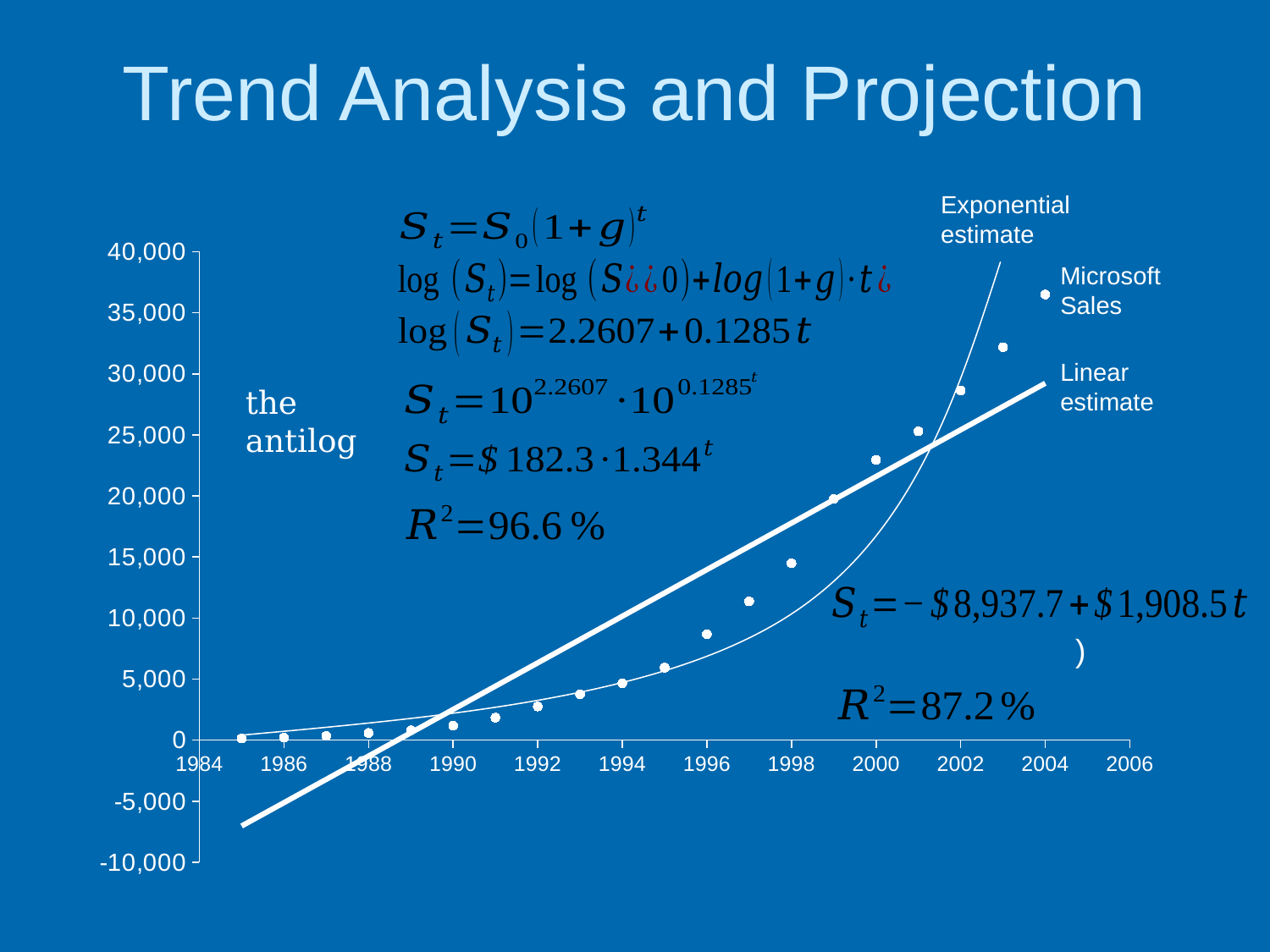
Is the Microsoft Sales value for 2002 greater or less than 30,000? less Which year has the highest Microsoft Sales value plotted? 2004 Is the Microsoft Sales value for 2000 greater or less than 20,000? greater What are the two estimate lines labelled on the chart? Exponential estimate and Linear estimate What kind of chart is shown on the slide? scatter chart Is the Microsoft Sales value for 1996 greater or less than 10,000? less Which year has the lowest Microsoft Sales value plotted? 1985 What is the R² value given for the exponential estimate? 96.6% Which year has the larger Microsoft Sales value, 1996 or 2004? 2004 Do the Microsoft Sales values rise or fall as the years increase along the x axis? rise